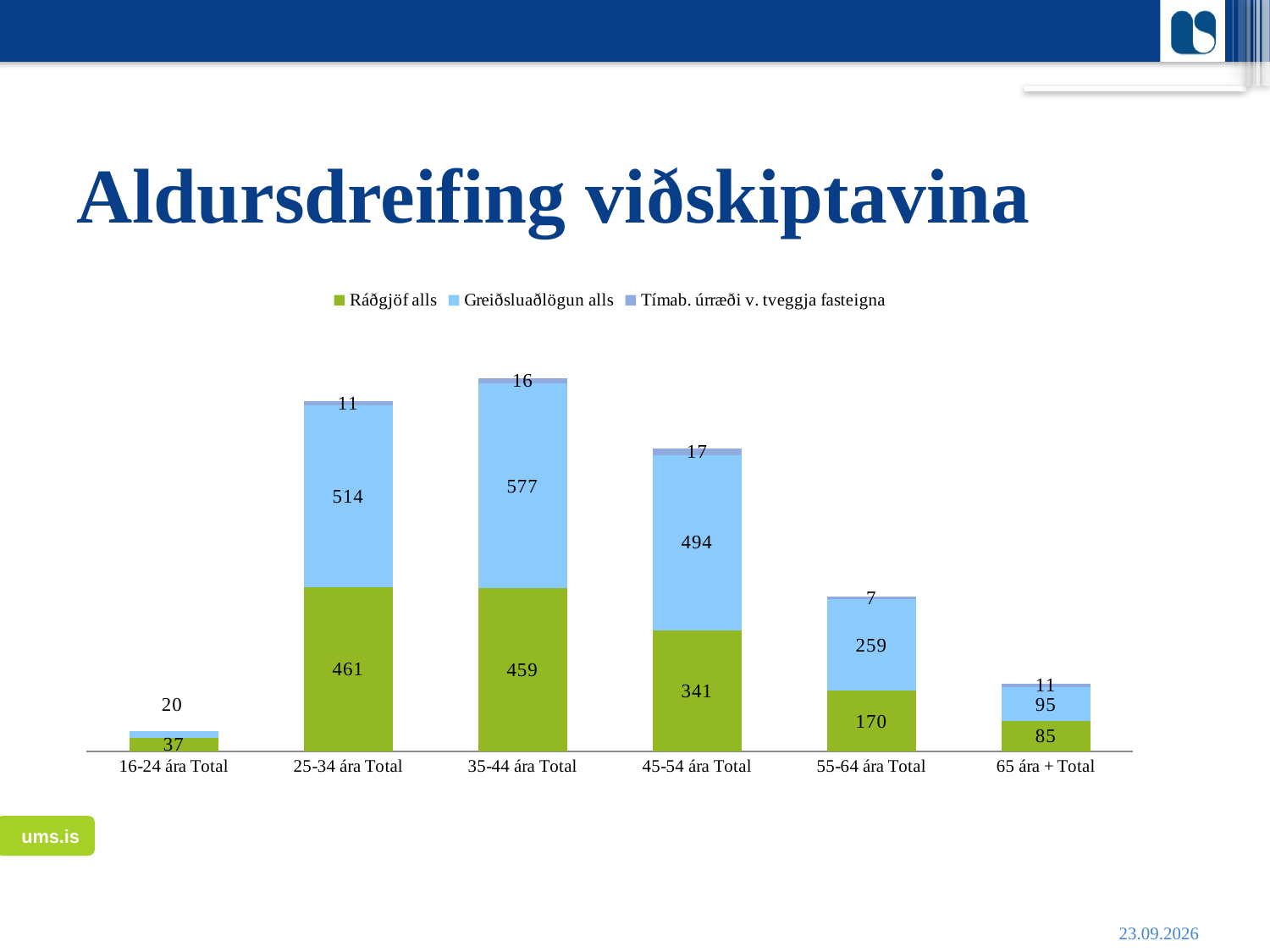
Which is larger: Ráðgjöf alls for 45-54 ára Total or Greiðsluaðlögun alls for 55-64 ára Total? Ráðgjöf alls for 45-54 ára Total What type of chart is shown on the slide? Stacked bar chart Which series is shown in green? Ráðgjöf alls What is the value of Tímab. úrræði v. tveggja fasteigna for 45-54 ára Total? 17 What is the total of the stacked bar for 55-64 ára Total? 436 How many series does the legend list? 3 Which age category has the lowest value for Ráðgjöf alls? 16-24 ára Total What is the difference between Greiðsluaðlögun alls for 35-44 ára Total and 25-34 ára Total? 63 How many age categories are shown on the x axis? 6 Which age category has the highest value for Greiðsluaðlögun alls? 35-44 ára Total What is the value of Ráðgjöf alls for 25-34 ára Total? 461 What is the value of Greiðsluaðlögun alls for 35-44 ára Total? 577